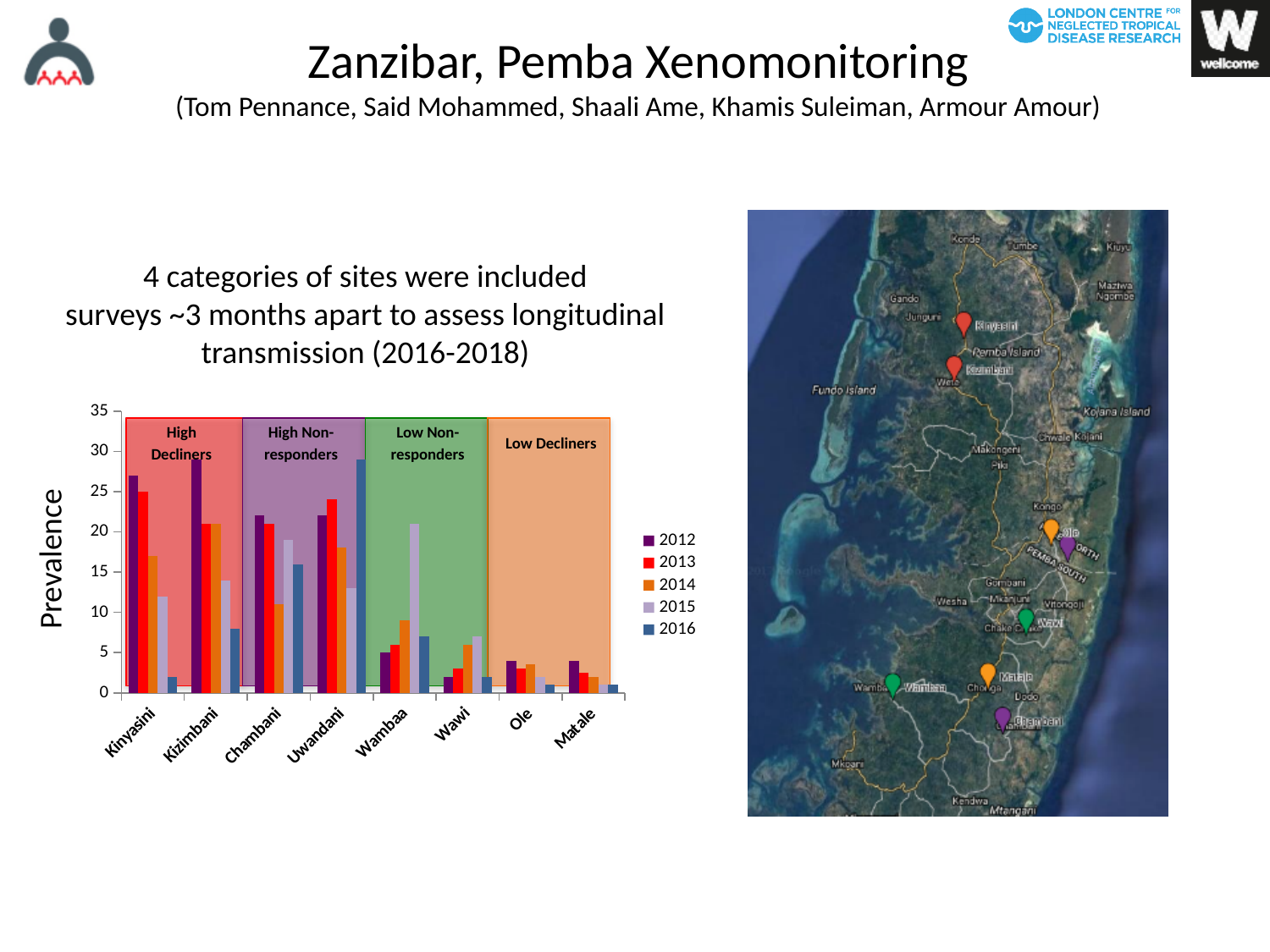
Which is larger for Wambaa, the 2012 value or the 2015 value? 2015 How many site categories are shown along the x axis of the chart? 8 How many series does the chart's legend list? 5 What kind of chart is shown on the slide? bar chart Is the 2012 value for Ole greater or less than 5? less Is the 2016 value for Uwandani greater or less than 25? greater Which is larger for Kinyasini, the 2012 value or the 2016 value? 2012 Is the 2015 value for Wambaa greater or less than 20? greater Which site has the highest 2016 value? Uwandani What is the label on the chart's vertical axis? Prevalence Which years are listed in the chart's legend? 2012, 2013, 2014, 2015, 2016